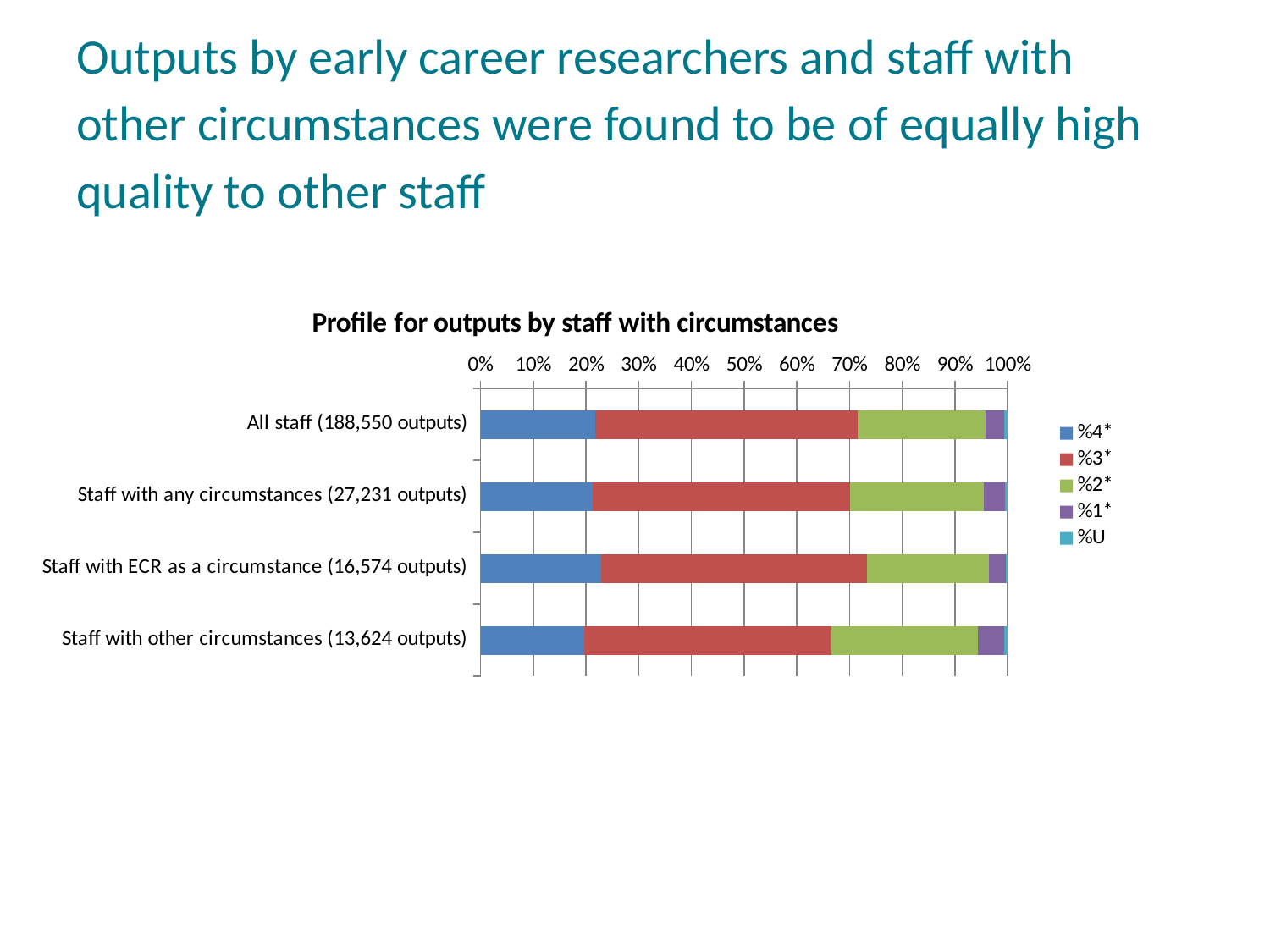
Which series is shown in red in the chart? %3* Is the %4* value for All staff greater or less than 30%? less Is the %3* value for All staff greater or less than 40%? greater Which category has the largest %2* segment? Staff with other circumstances (13,624 outputs) What type of chart is shown on the slide? Stacked bar chart Is the %1* value for Staff with ECR as a circumstance greater or less than 10%? less Which is larger, the %2* value for Staff with other circumstances or for All staff? Staff with other circumstances How many categories (bars) are shown in the chart? 4 What is the title of the chart? Profile for outputs by staff with circumstances Which is larger, the %4* value for Staff with ECR as a circumstance or for Staff with other circumstances? Staff with ECR as a circumstance How many series does the legend list? 5